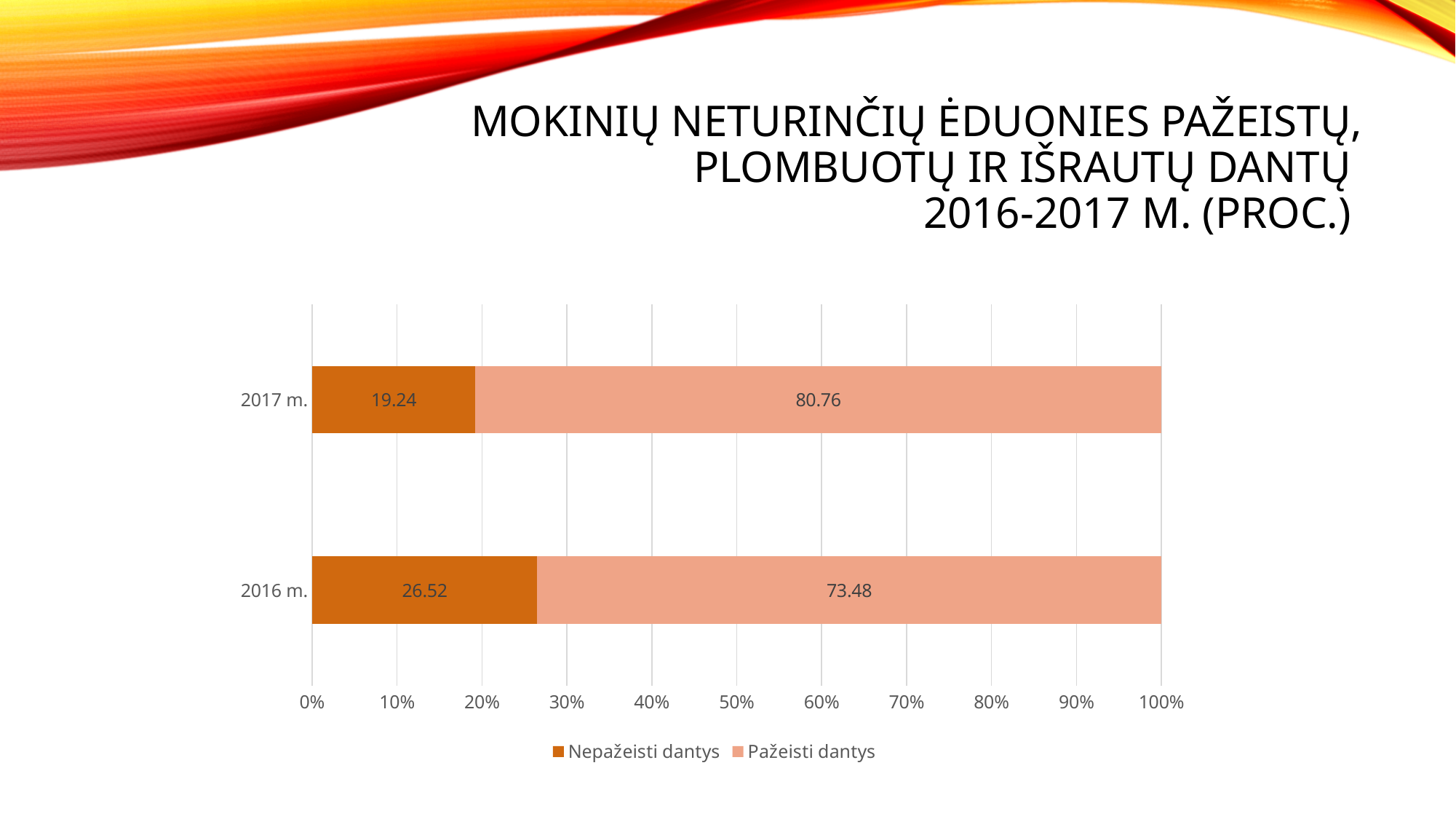
What is the value for Pažeisti dantys in 2017 m.? 80.76 How many series does the legend list? 2 What is the value for Nepažeisti dantys in 2017 m.? 19.24 What is the value for Nepažeisti dantys in 2016 m.? 26.52 What is the difference between the Nepažeisti dantys values for 2016 m. and 2017 m.? 7.28 What kind of chart is shown on the slide? Stacked bar chart Which series is shown in dark orange in the legend? Nepažeisti dantys Which year has the higher value for Nepažeisti dantys? 2016 m. How many years (categories) are shown on the chart? 2 Is the Pažeisti dantys value larger in 2017 m. or in 2016 m.? 2017 m. Which year has the lower value for Pažeisti dantys? 2016 m. What is the value for Pažeisti dantys in 2016 m.? 73.48